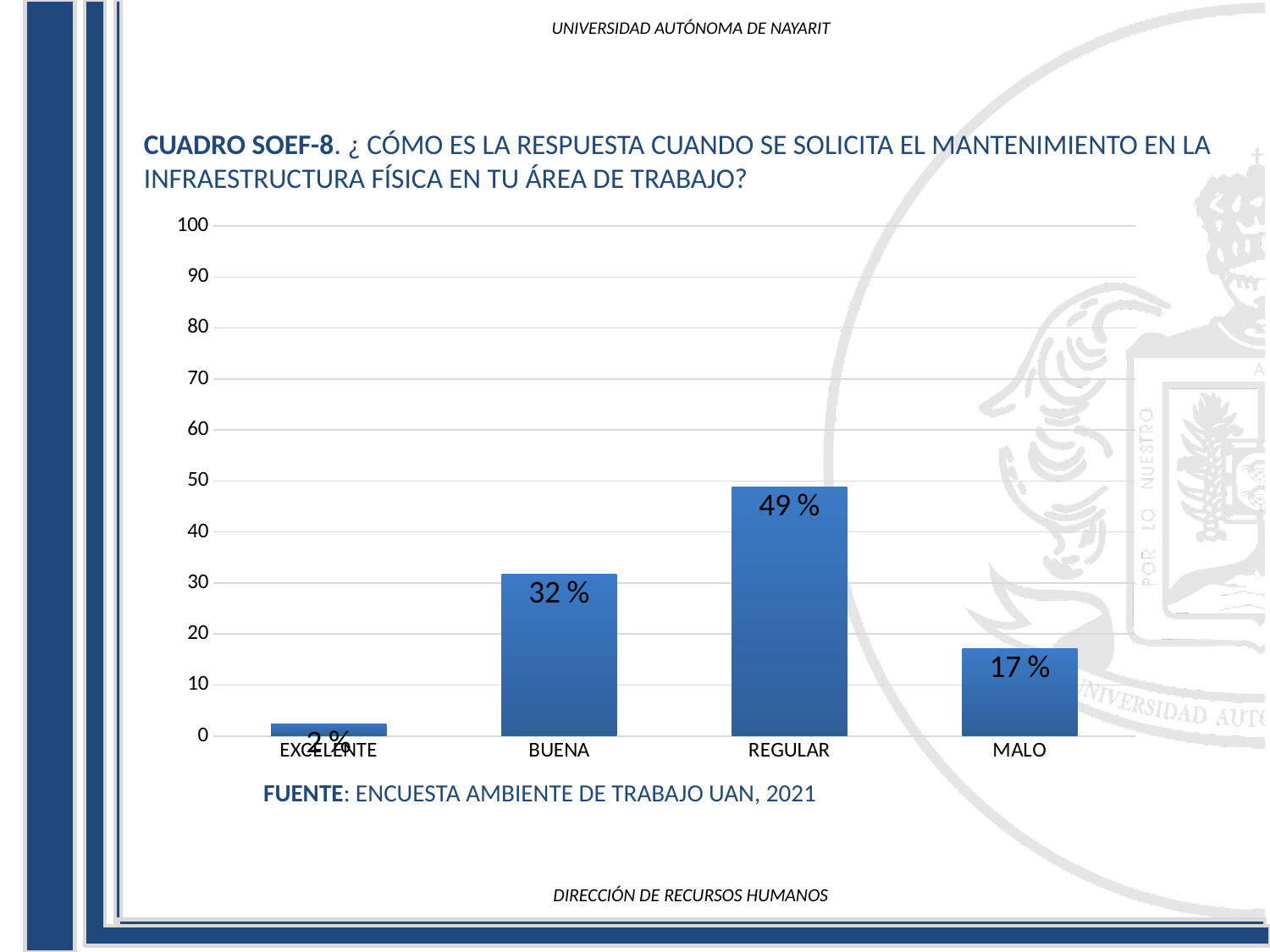
Which is larger, the value for BUENA or the value for MALO? BUENA What is the value for MALO? 17 % What is the value for BUENA? 32 % Which category has the highest value? REGULAR What is the difference between the values for BUENA and MALO? 15 % Which category has the lowest value? EXCELENTE What is the value for EXCELENTE? 2 % What kind of chart is shown on the slide? bar chart Is the value for REGULAR greater or less than 40? greater What is the difference between the values for REGULAR and BUENA? 17 % How many categories are shown on the x axis? 4 What is the value for REGULAR? 49 %